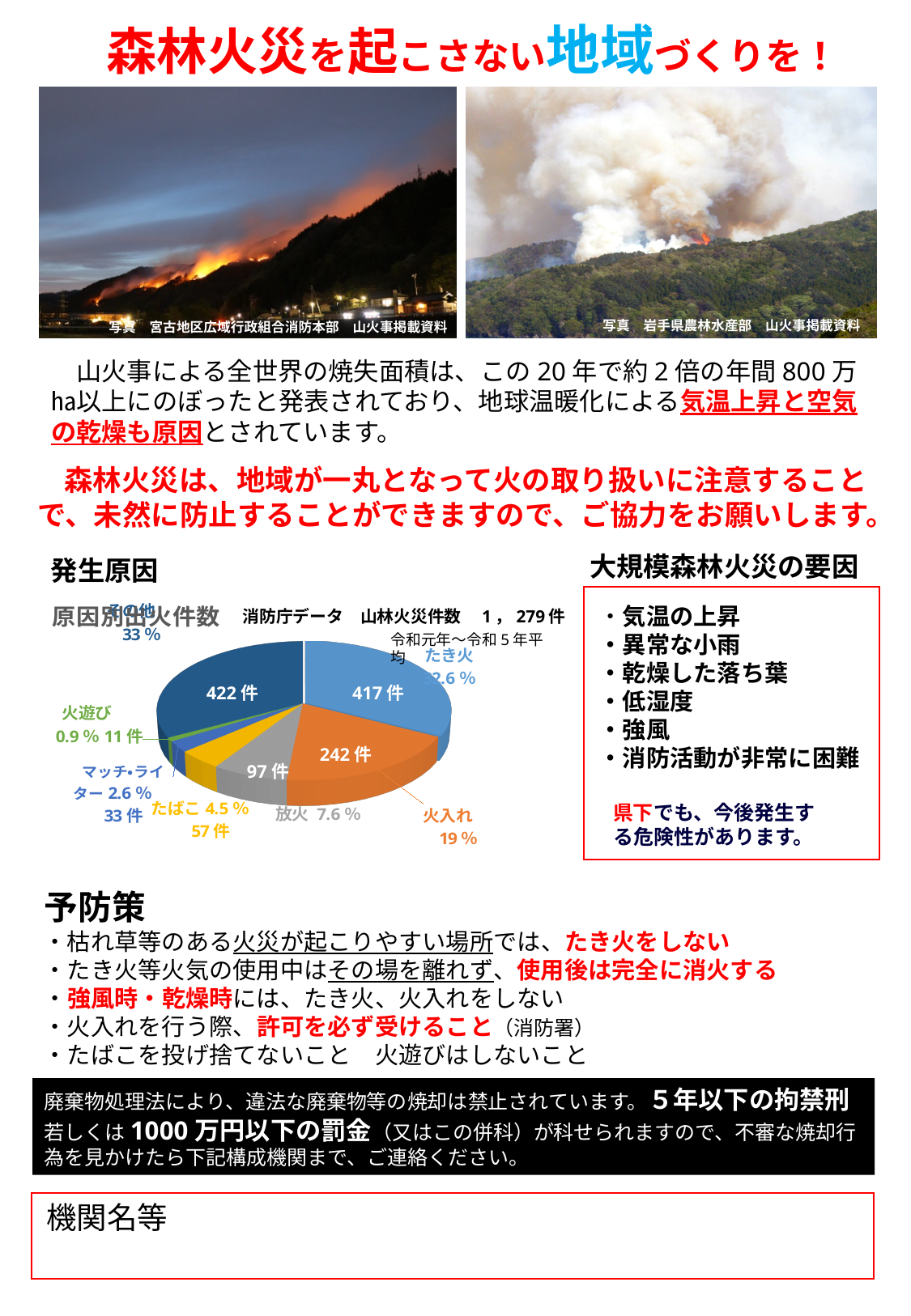
In the 原因別出火件数 pie chart, what share of fires is attributed to 火入れ? 19% In the 原因別出火件数 pie chart, how many cases are attributed to 火入れ? 242件 In the 原因別出火件数 pie chart, which has more cases, 放火 or たばこ? 放火 According to the text above the 原因別出火件数 pie chart, what is the total number of 山林火災件数 from the 消防庁データ? 1,279件 In the 原因別出火件数 pie chart, how many cases are attributed to 放火? 97件 In the 原因別出火件数 pie chart, what share of fires is attributed to 火遊び? 0.9% In the 原因別出火件数 pie chart, how many cases are attributed to たばこ? 57件 In the 原因別出火件数 pie chart, which cause has the fewest cases? 火遊び What kind of chart is used to show 原因別出火件数? pie chart In the 原因別出火件数 pie chart, how many cases are attributed to たき火? 417件 In the 原因別出火件数 pie chart, how many more cases are attributed to たき火 than to 火入れ? 175件 How many cause categories are shown in the 原因別出火件数 pie chart? 7